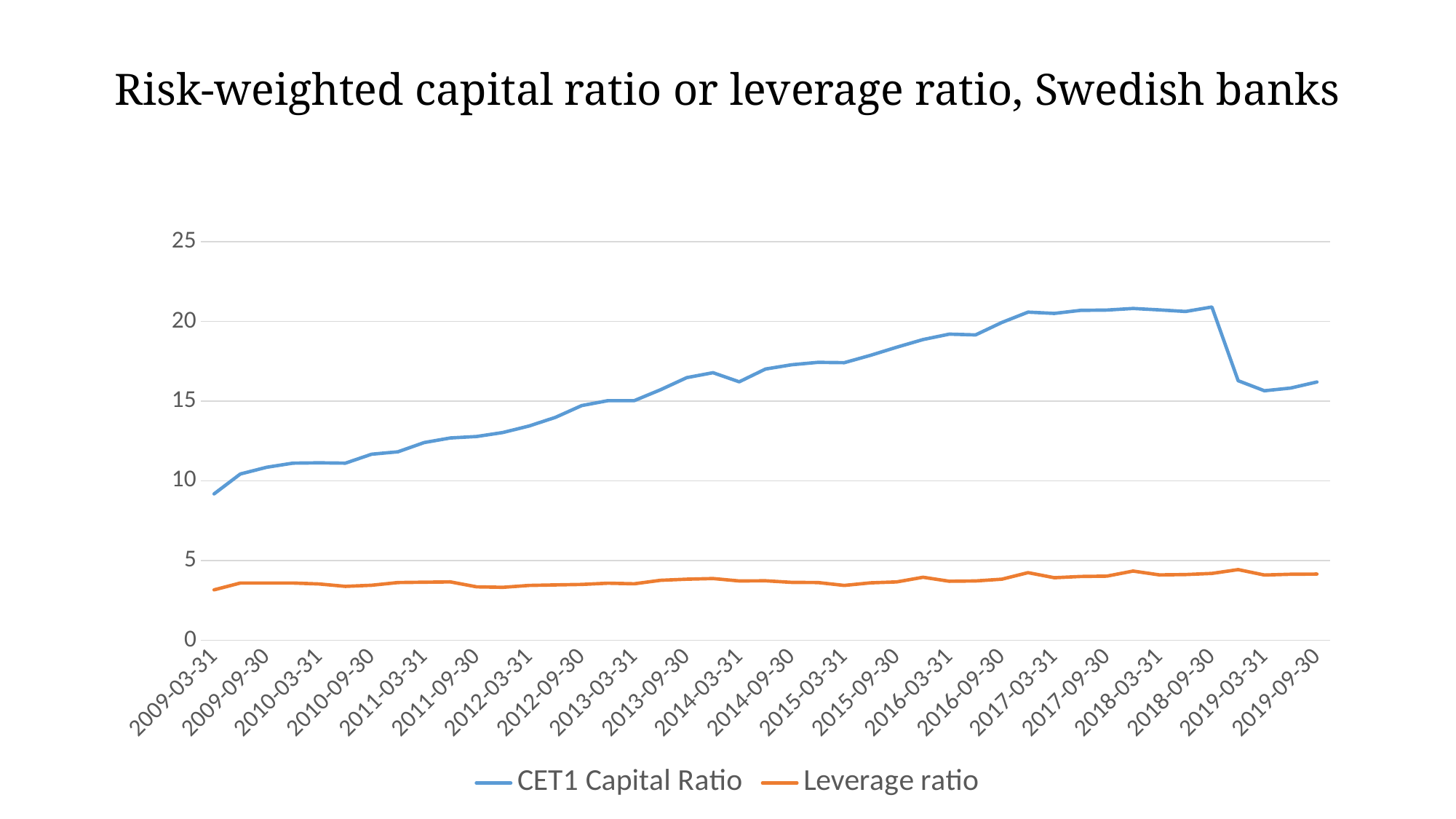
Does the CET1 Capital Ratio rise or fall between 2009-03-31 and 2018-03-31? rise Is the Leverage ratio at 2009-03-31 greater or less than 5? less Is the CET1 Capital Ratio at 2009-03-31 greater or less than 10? less Is the Leverage ratio at 2019-09-30 greater or less than 5? less At which date is the CET1 Capital Ratio lowest? 2009-03-31 Which series has the higher value at 2015-03-31, CET1 Capital Ratio or Leverage ratio? CET1 Capital Ratio How many series does the legend list? 2 What kind of chart is shown on the slide? line chart What is the title of the chart? Risk-weighted capital ratio or leverage ratio, Swedish banks Which series is drawn in orange? Leverage ratio